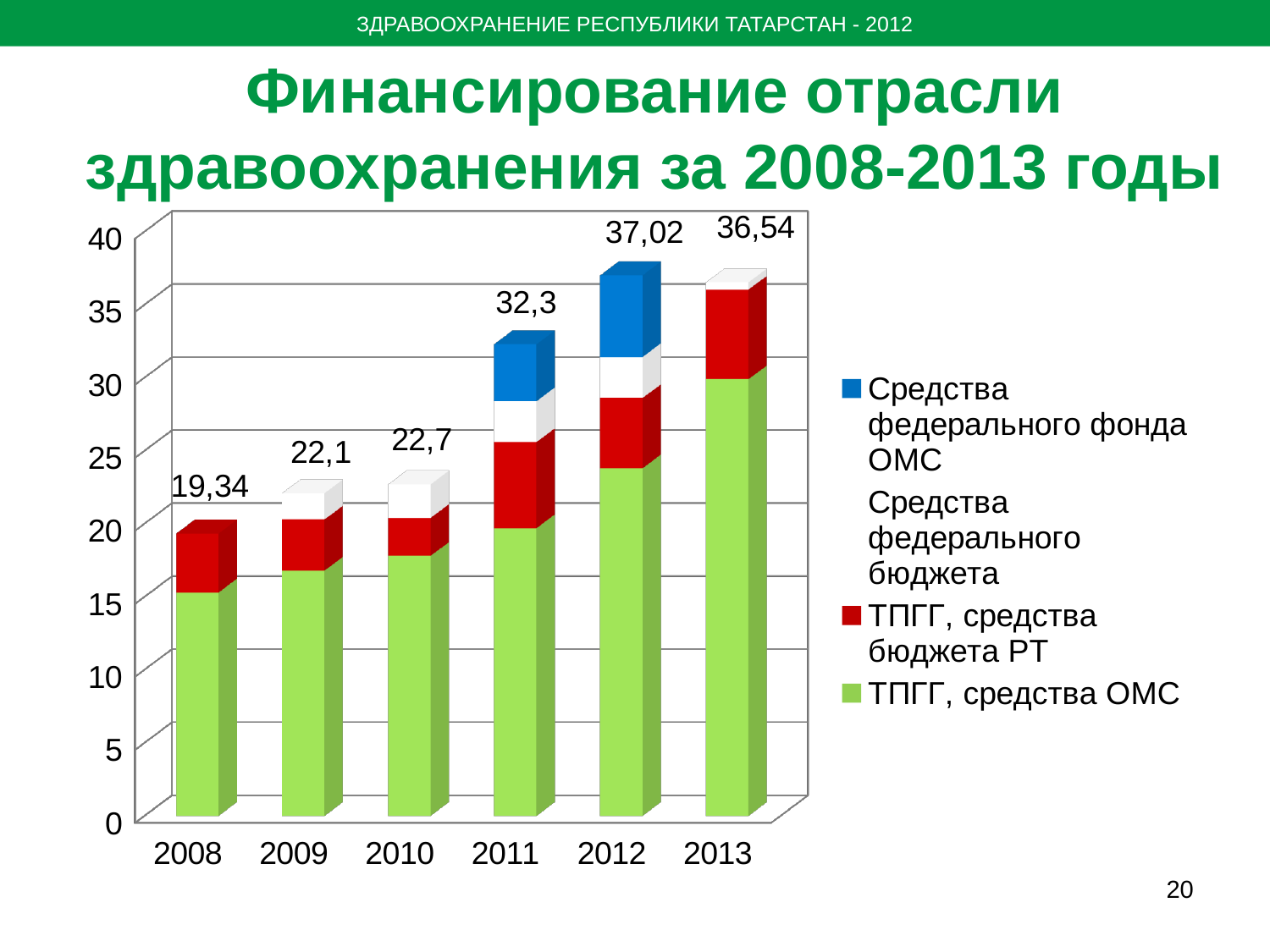
What kind of chart is shown on the slide? stacked bar chart What is the total value labelled for 2011? 32,3 What is the difference between the totals for 2010 and 2009? 0,6 What is the total value labelled for 2013? 36,54 Is the value of the green segment (ТПГГ, средства ОМС) for 2013 greater or less than 25? greater What is the total value labelled for 2008? 19,34 What is the difference between the totals for 2012 and 2011? 4,72 Which year has the highest total value? 2012 How many series does the legend list? 4 How many years are shown on the x axis? 6 Which total is larger, 2012 or 2013? 2012 Which year has the lowest total value? 2008